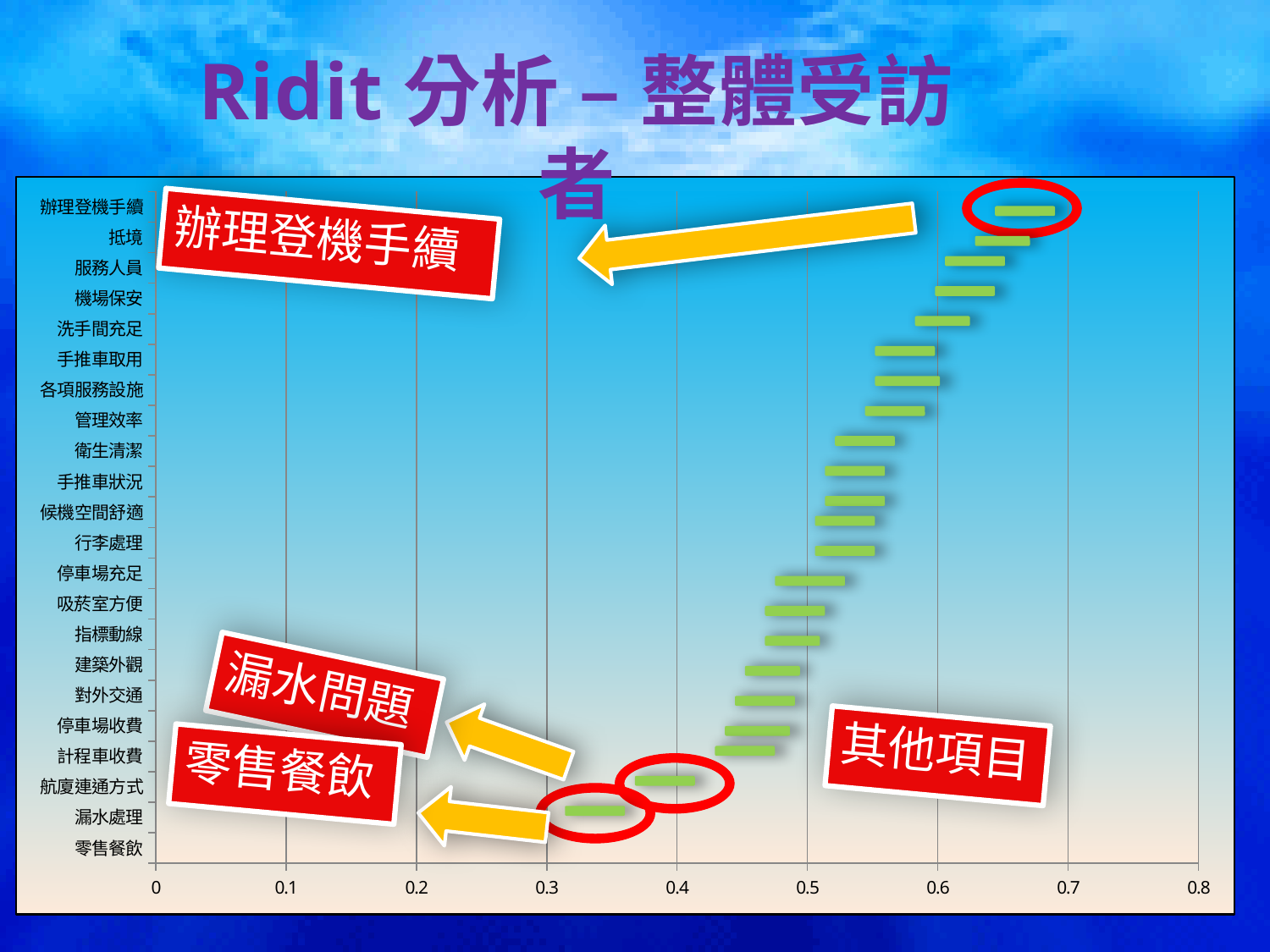
Is the value for 零售餐飲 greater or less than 0.5? less Which category has the highest value in the chart? 辦理登機手續 Is the value for 辦理登機手續 greater or less than 0.6? greater Is the value for 漏水處理 greater or less than 0.3? greater How many categories are listed on the vertical axis of the chart? 22 Do the values rise or fall when reading the categories from top to bottom of the chart? fall Which category has the lowest value in the chart? 零售餐飲 Which has the larger value, 辦理登機手續 or 零售餐飲? 辦理登機手續 What is the title of the slide? Ridit 分析 – 整體受訪者 What kind of chart is shown on the slide? bar chart